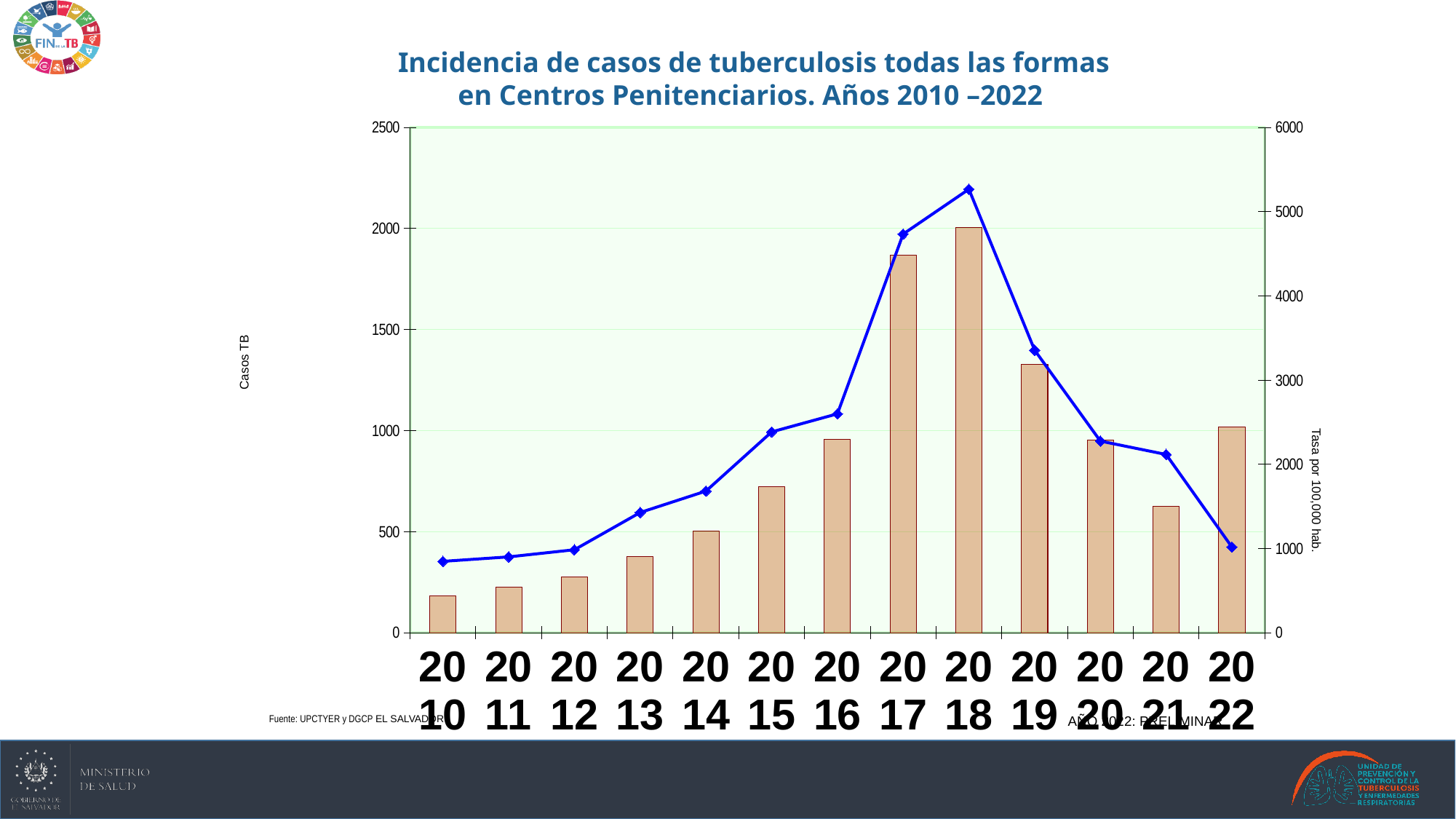
Which year has a taller Casos TB bar, 2022 or 2021? 2022 Which year has a taller Casos TB bar, 2017 or 2019? 2017 Which year has the shortest bar for Casos TB? 2010 How many years are shown on the x axis? 13 What kind of chart is this? Combined bar and line chart Which year has the tallest bar for Casos TB? 2018 Is the Casos TB bar for 2019 greater or less than 1000? greater What is the title of the right-hand vertical axis? Tasa por 100,000 hab. Is the Casos TB bar for 2017 greater or less than 1500? greater Do the Casos TB bars rise or fall from 2010 to 2018? Rise Is the Casos TB bar for 2021 greater or less than 1000? less